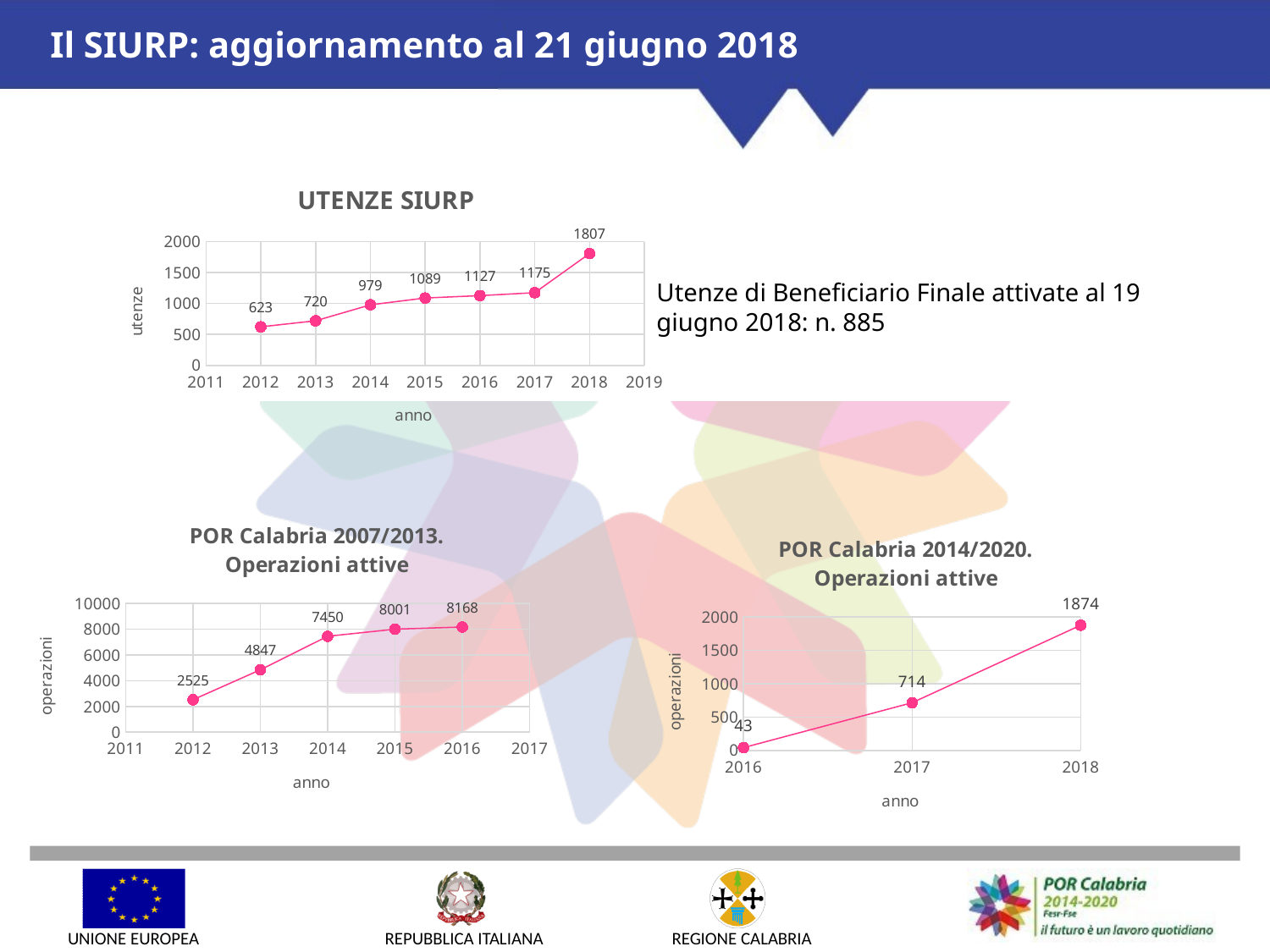
In the 'UTENZE SIURP' chart, how many data points are plotted? 7 In the 'POR Calabria 2014/2020. Operazioni attive' chart, what is the value for 2017? 714 In the 'POR Calabria 2007/2013. Operazioni attive' chart, what is the difference between the 2013 and 2012 values? 2322 Which is larger: the 2016 value in the 'POR Calabria 2007/2013. Operazioni attive' chart or the 2018 value in the 'POR Calabria 2014/2020. Operazioni attive' chart? 2016 value in POR Calabria 2007/2013 (8168) In the 'POR Calabria 2014/2020. Operazioni attive' chart, which year has the highest value? 2018 In the 'UTENZE SIURP' chart, what is the value for 2018? 1807 In the 'UTENZE SIURP' chart, what is the difference between the 2018 and 2017 values? 632 What type of chart is the 'POR Calabria 2014/2020. Operazioni attive' chart? line chart In the 'UTENZE SIURP' chart, what is the value for 2012? 623 In the 'UTENZE SIURP' chart, do the values rise or fall from 2012 to 2018? rise In the 'POR Calabria 2007/2013. Operazioni attive' chart, which year has the lowest value? 2012 In the 'POR Calabria 2007/2013. Operazioni attive' chart, what is the value for 2014? 7450